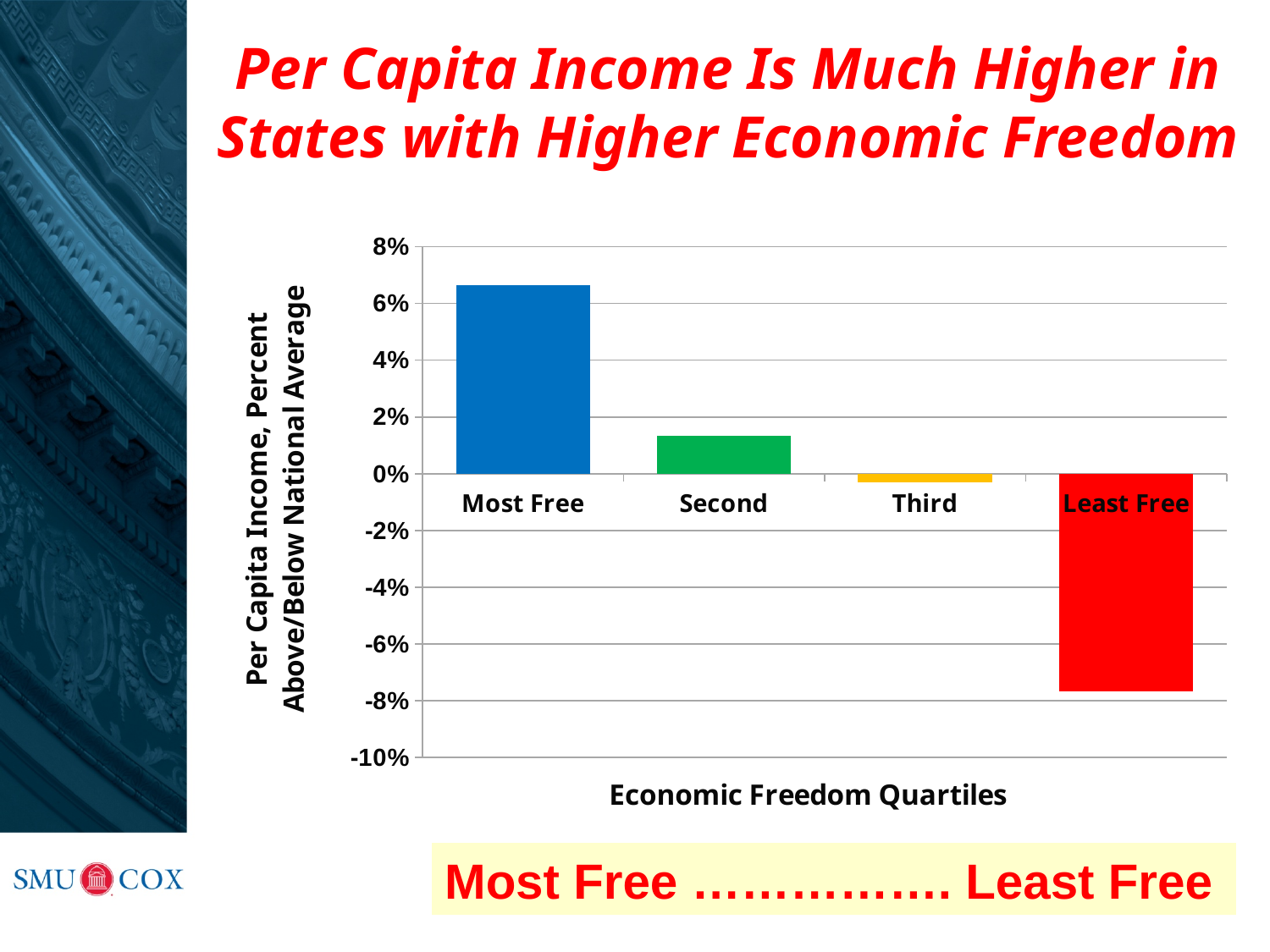
Which quartile has the highest per capita income relative to the national average? Most Free Which is larger, the value for Second or the value for Third? Second What colour is the bar for Least Free? red How many economic freedom quartiles are plotted on the chart? 4 Do the values rise or fall moving from Most Free to Least Free along the x axis? fall Which quartile has the lowest per capita income relative to the national average? Least Free Is the value for Second greater or less than 2%? less Is the value for Most Free greater or less than 6%? greater Is the value for Least Free greater or less than -6%? less What kind of chart is shown on the slide? bar chart What is the label of the x axis? Economic Freedom Quartiles